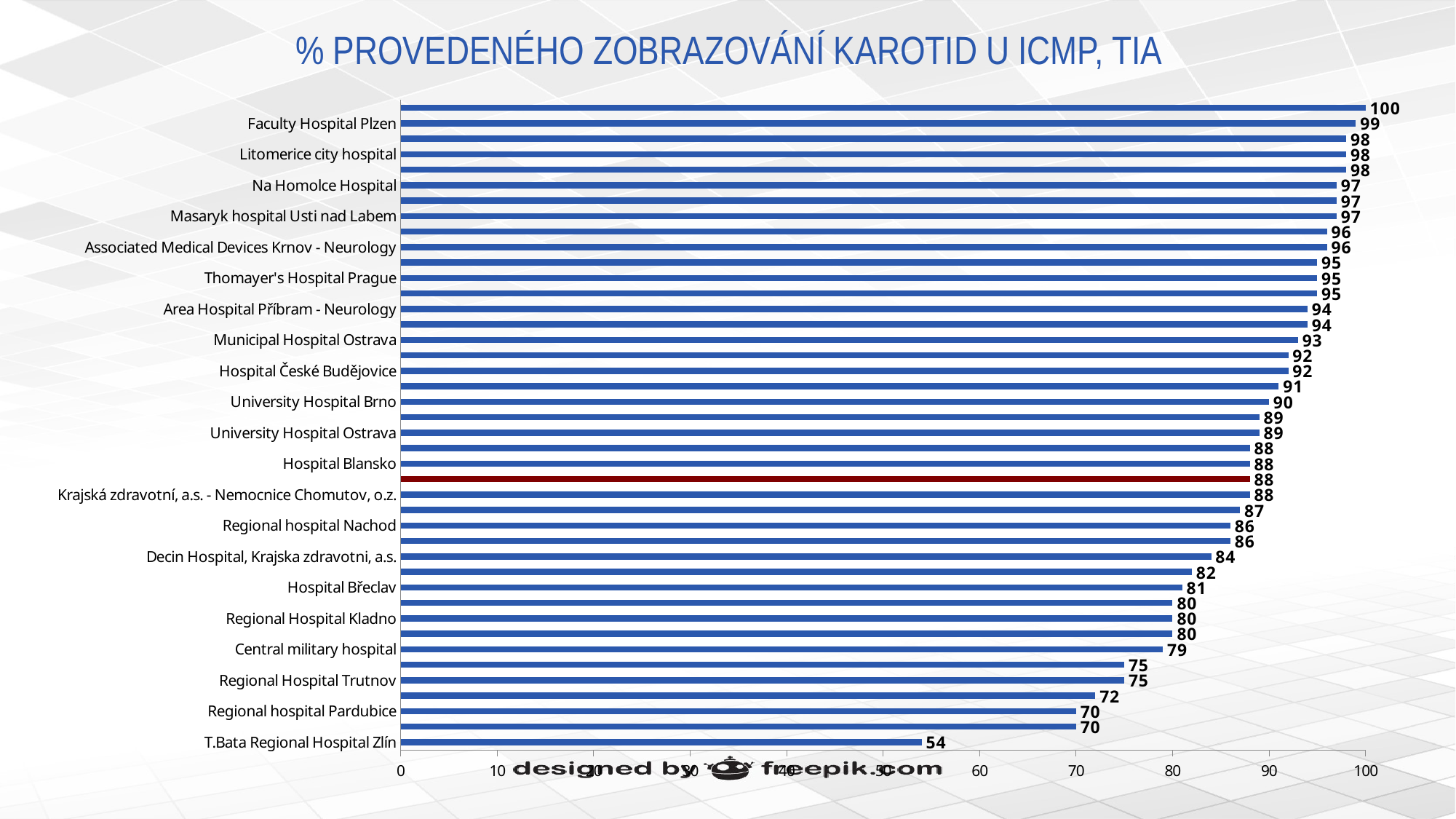
Is the value for Regional hospital Pardubice greater or less than 80? less What is the value for Decin Hospital, Krajska zdravotni, a.s.? 84 What is the value for Central military hospital? 79 What is the value for Municipal Hospital Ostrava? 93 Which hospital has the lowest value in the chart? T.Bata Regional Hospital Zlín What is the difference between the values for Regional hospital Pardubice and T.Bata Regional Hospital Zlín? 16 What is the value for Regional hospital Pardubice? 70 What kind of chart is shown on the slide? bar chart Which has a larger value, Decin Hospital, Krajska zdravotni, a.s. or Central military hospital? Decin Hospital, Krajska zdravotni, a.s. What is the value for T.Bata Regional Hospital Zlín? 54 What is the title of the chart? % PROVEDENÉHO ZOBRAZOVÁNÍ KAROTID U ICMP, TIA What is the highest value shown on the x axis? 100